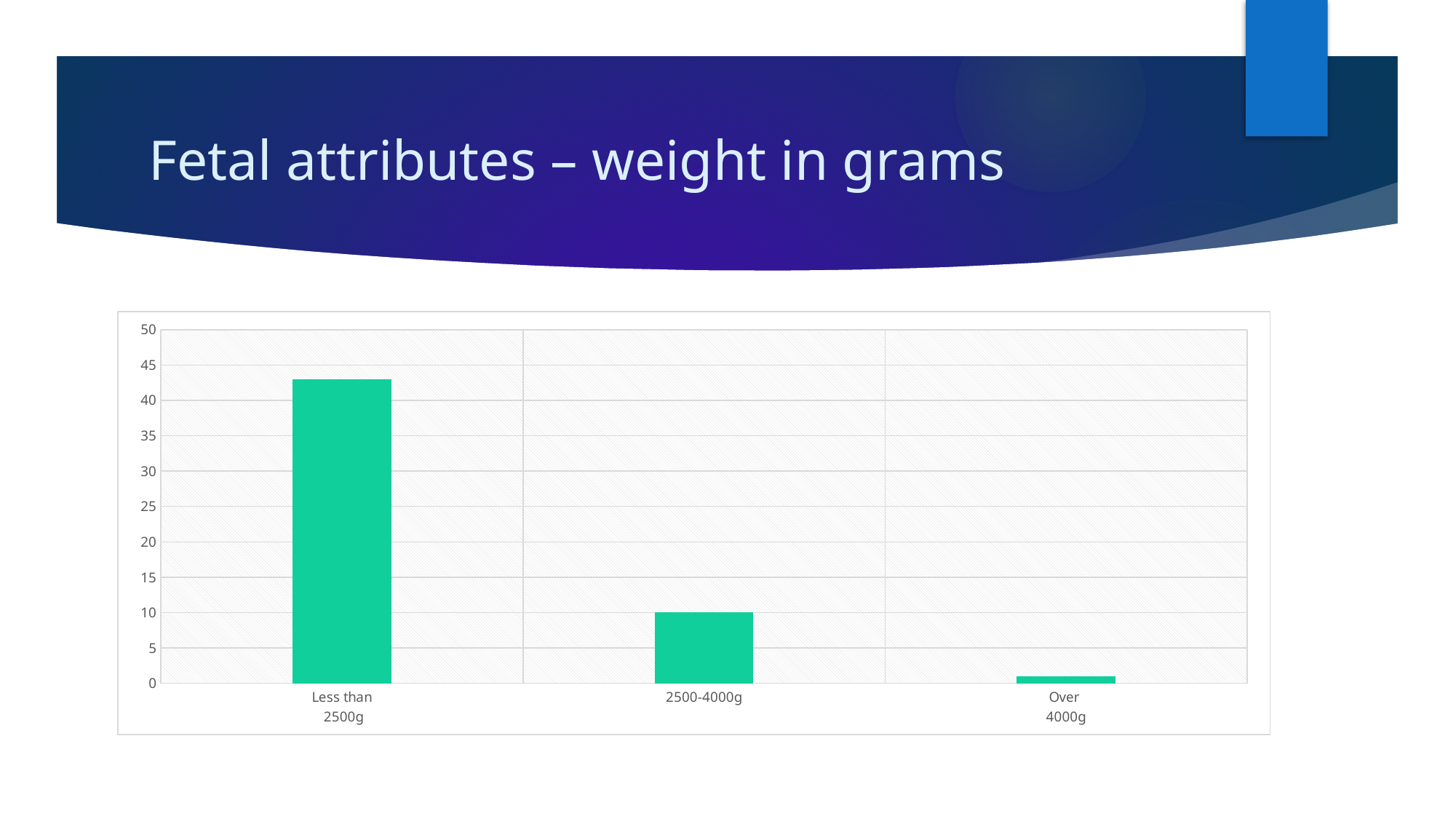
How many categories are shown on the x axis of the chart? 3 What is the highest value shown on the vertical axis? 50 Do the bar values rise or fall from left to right along the x axis? fall What is the value for 2500-4000g? 10 Is the value for Over 4000g greater or less than 5? less Which is larger, the value for 2500-4000g or the value for Over 4000g? 2500-4000g What kind of chart is shown on the slide? bar chart Which category has the lowest bar? Over 4000g Which category has the highest bar? Less than 2500g What is the title of the slide containing the chart? Fetal attributes – weight in grams Is the value for Less than 2500g greater or less than 40? greater Is the value for Less than 2500g greater or less than 45? less